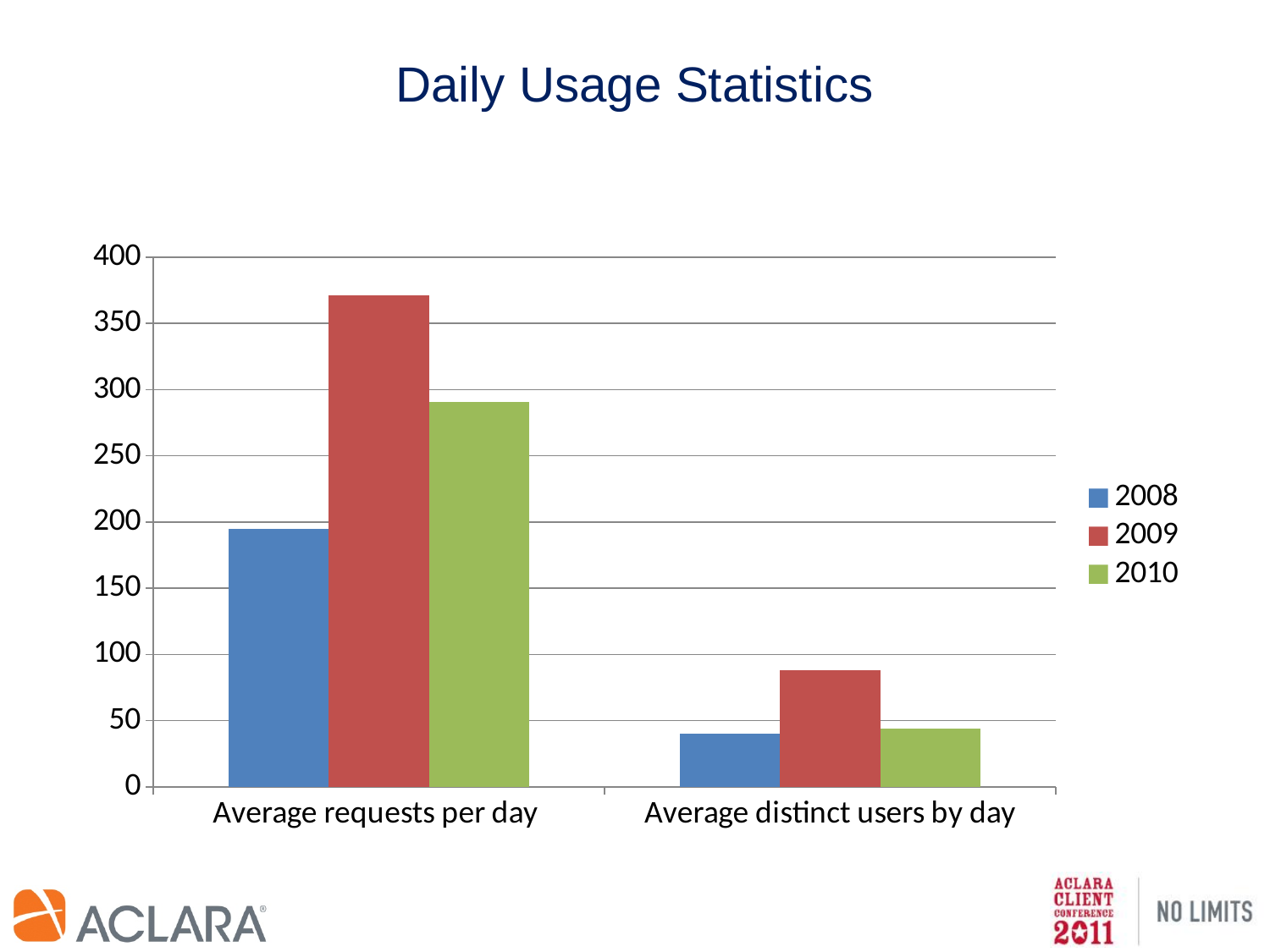
Is the value for 2010 in Average requests per day greater or less than 250? greater Is the value for 2009 in Average requests per day greater or less than 350? greater How many series does the legend list? 3 Which is larger: the 2010 value for Average requests per day or the 2008 value for Average requests per day? 2010 What is the title of the chart? Daily Usage Statistics What kind of chart is shown on the slide? bar chart How many categories are shown on the x axis? 2 Is the value for 2009 in Average distinct users by day greater or less than 100? less Which year has the highest value for Average requests per day? 2009 Which year has the highest value for Average distinct users by day? 2009 Which year has the lowest value for Average requests per day? 2008